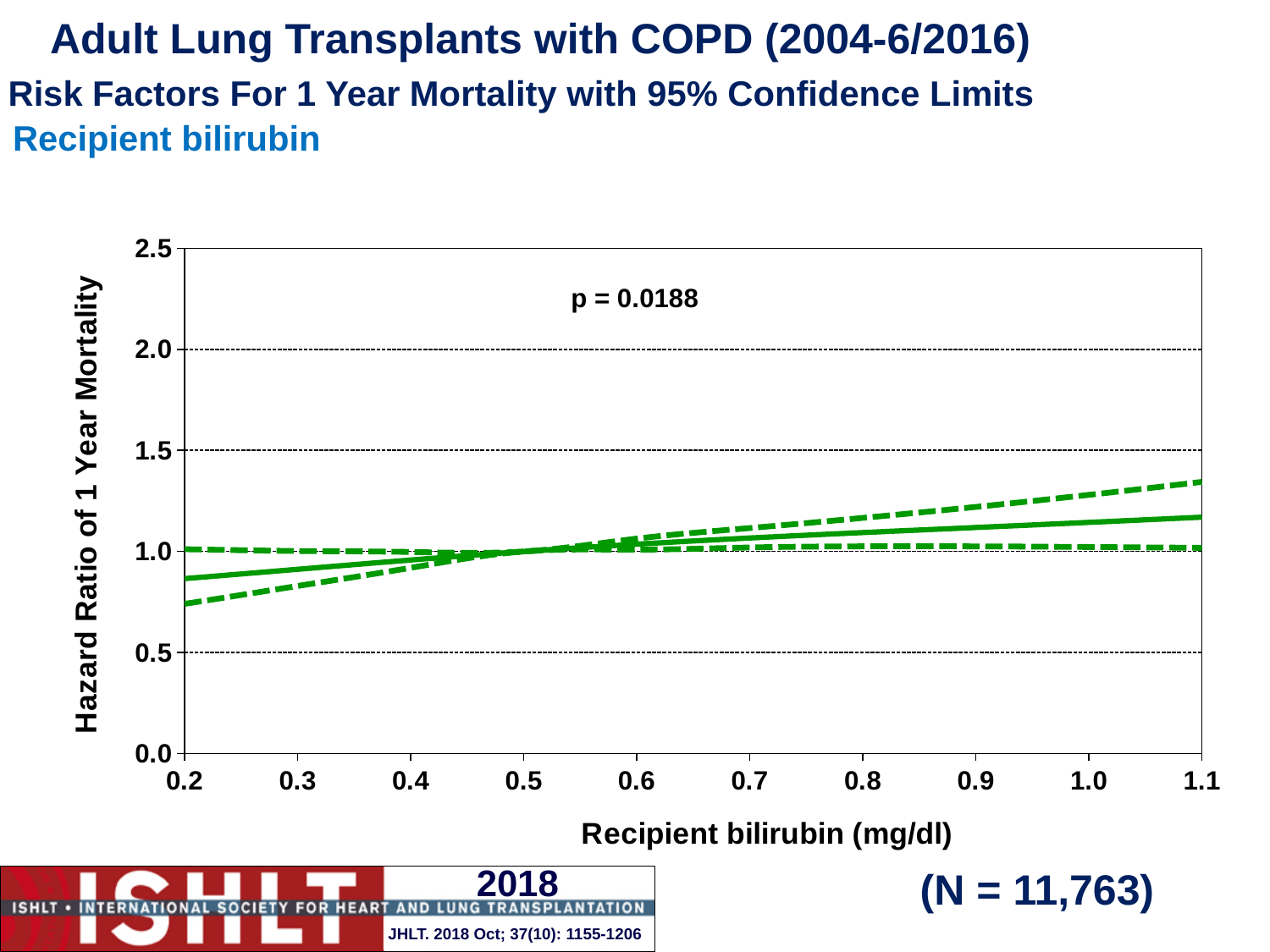
How many lines are plotted on the chart (including the confidence limits)? 3 What is the label of the x axis of the chart? Recipient bilirubin (mg/dl) Is the lower 95% confidence limit at a recipient bilirubin of 0.2 mg/dl greater or less than 0.5? greater How many tick labels are shown on the x axis of the chart? 10 Is the hazard ratio (solid line) at a recipient bilirubin of 0.2 mg/dl greater or less than 1.0? less Is the hazard ratio (solid line) at a recipient bilirubin of 1.1 mg/dl greater or less than 1.0? greater What kind of chart is shown on the slide? line chart What is the p-value printed on the chart? p = 0.0188 Does the hazard ratio of 1 year mortality rise or fall as recipient bilirubin increases from 0.2 to 1.1 mg/dl? rise